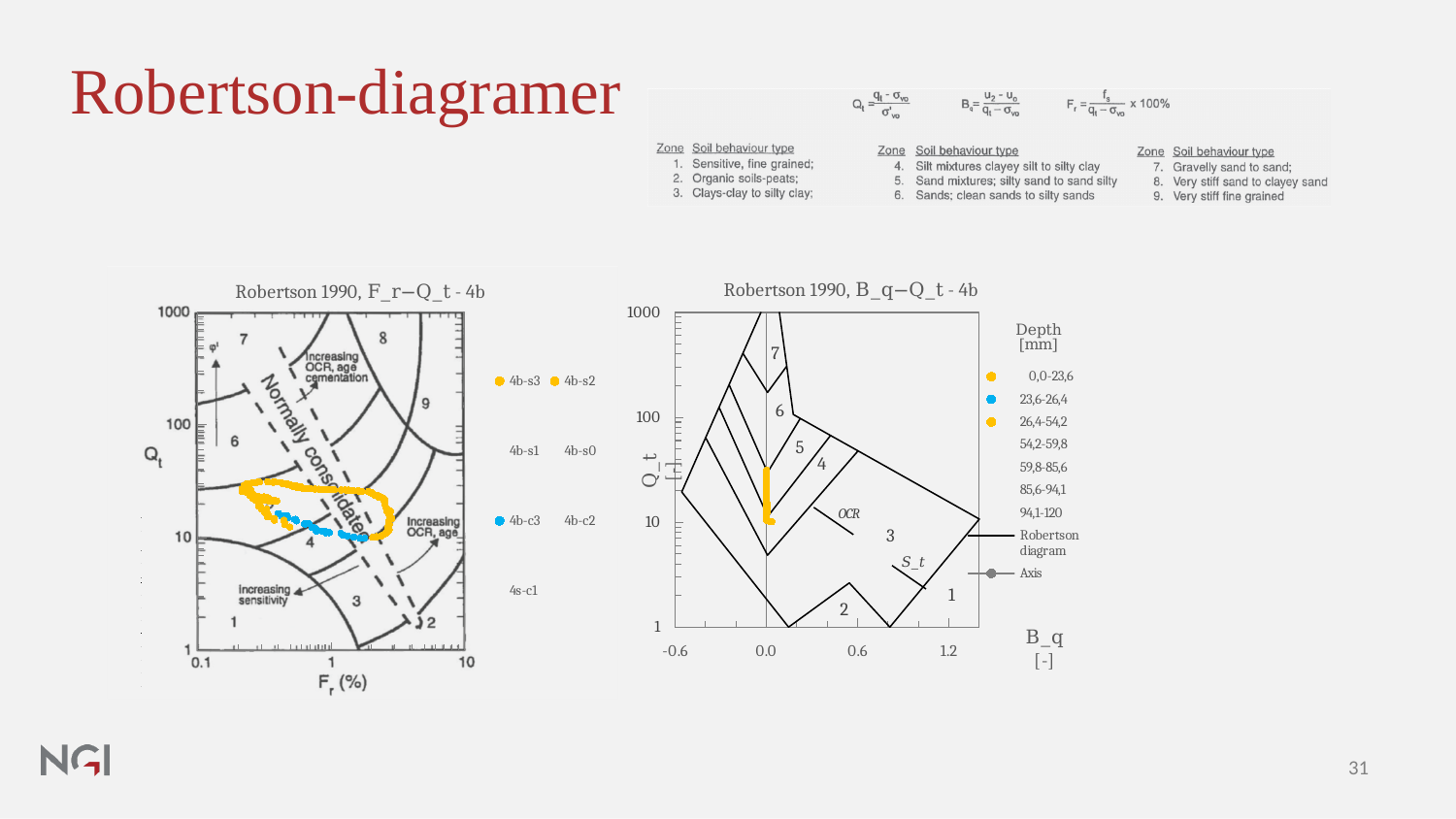
What kind of chart is the 'Robertson 1990, B_q–Q_t - 4b' chart? Scatter plot What kind of chart is the 'Robertson 1990, F_r–Q_t - 4b' chart? Scatter plot On the 'Robertson 1990, B_q–Q_t - 4b' chart, are the Q_t values of the plotted data points greater or less than 1? greater How many depth ranges does the legend of the 'Robertson 1990, B_q–Q_t - 4b' chart list? 7 How many numbered soil behaviour zones are drawn on the 'Robertson 1990, F_r–Q_t - 4b' chart? 9 On the 'Robertson 1990, F_r–Q_t - 4b' chart, are the Q_t values of the blue data points greater or less than 1? greater What is the x-axis label of the 'Robertson 1990, F_r–Q_t - 4b' chart? F_r (%) On the 'Robertson 1990, F_r–Q_t - 4b' chart, are the Q_t values of the plotted data points greater or less than 100? less What is the x-axis label of the 'Robertson 1990, B_q–Q_t - 4b' chart? B_q [-] How many numbered soil behaviour zones are drawn on the 'Robertson 1990, B_q–Q_t - 4b' chart? 7